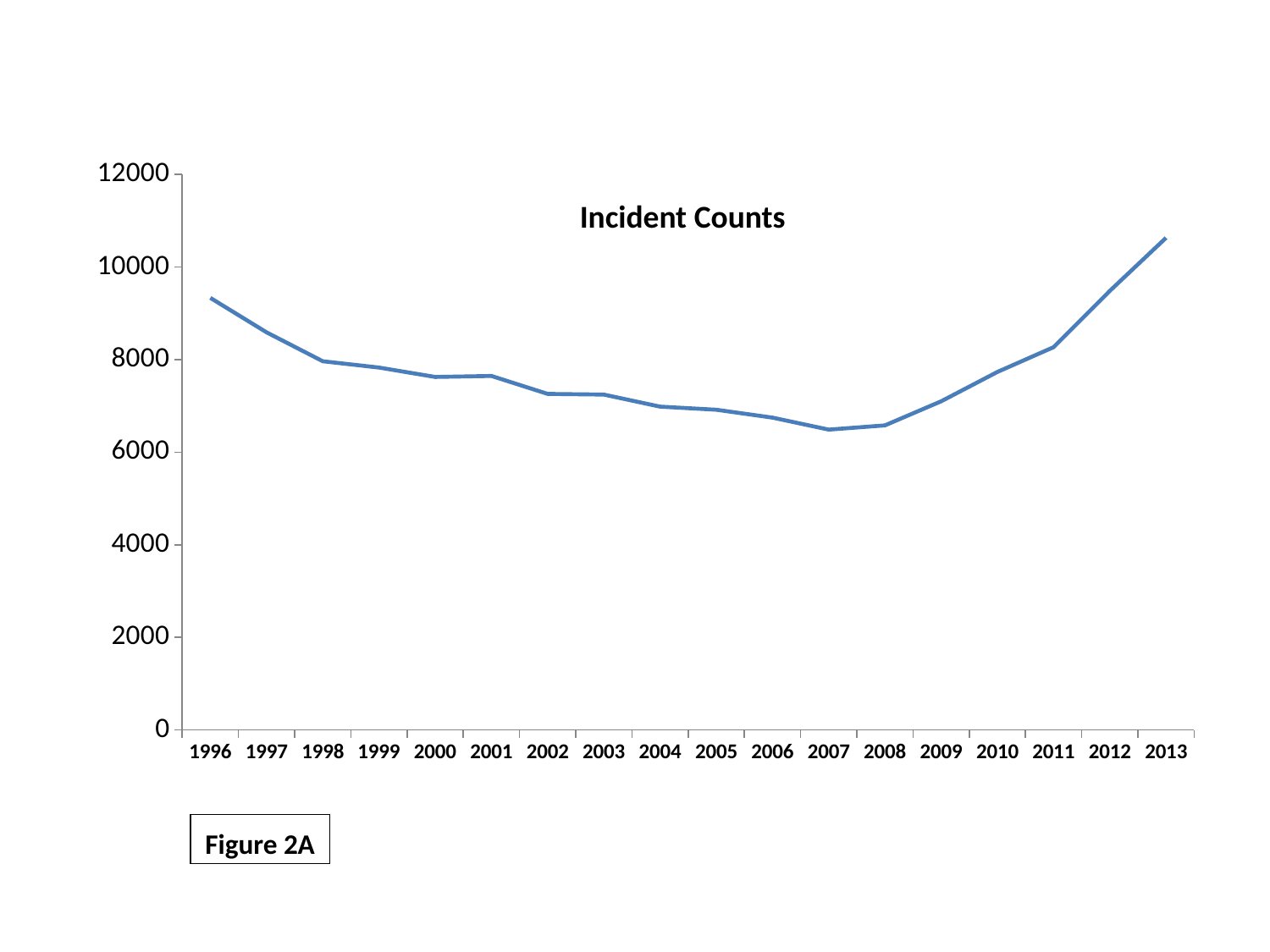
Which year has a higher incident count, 1998 or 2008? 1998 Is the value for 2004 greater or less than 8000? less Do the incident counts rise or fall from 2008 to 2013? rise Is the value for 2013 greater or less than 10000? greater Is the value for 2007 greater or less than 6000? greater How many years are plotted along the x axis? 18 Which year has the highest incident count? 2013 What kind of chart is shown on the slide? line chart What is the title of the chart? Incident Counts Which year has the lowest incident count? 2007 Which year has a higher incident count, 1996 or 2013? 2013